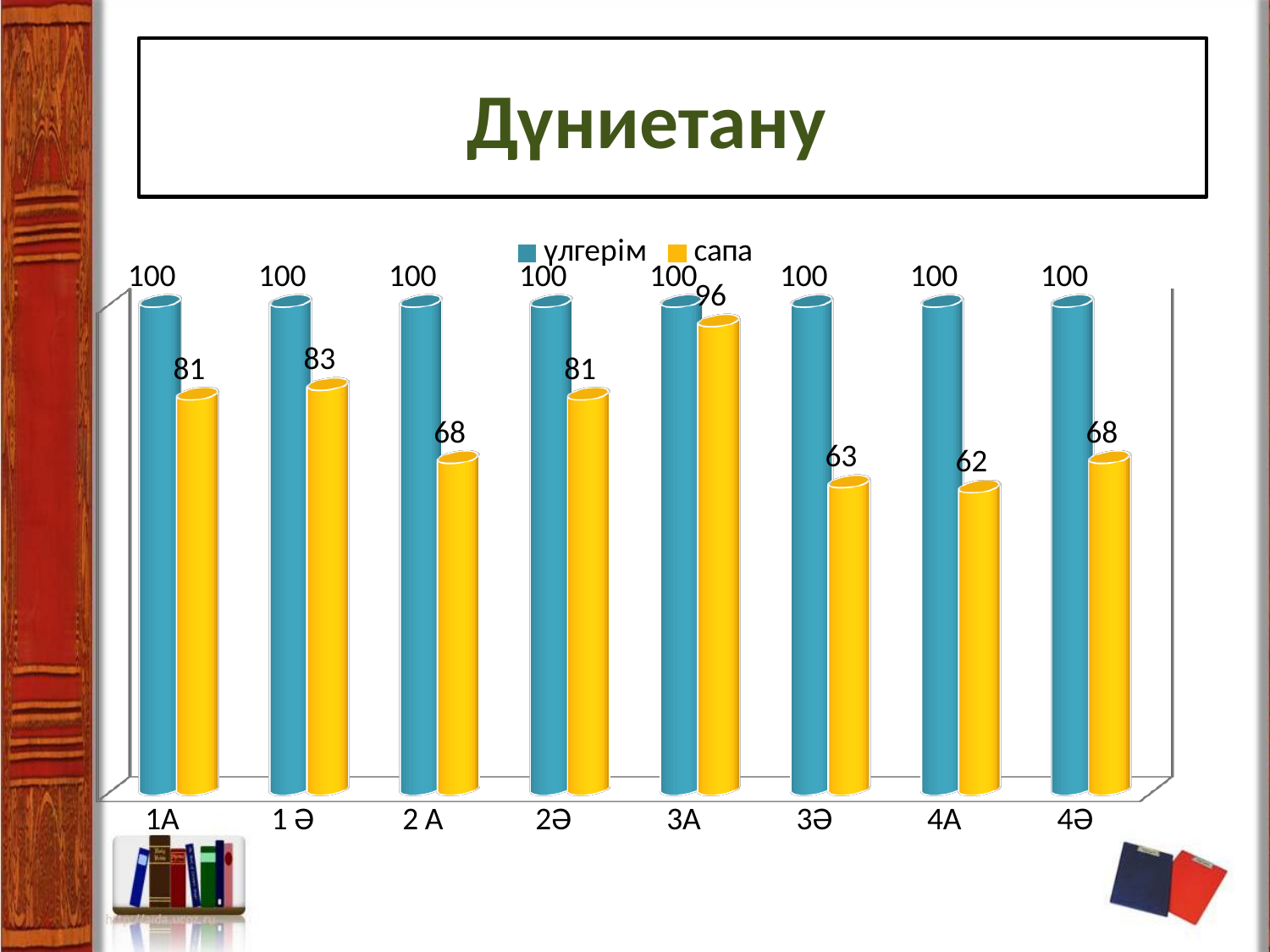
Which category has the lowest сапа value? 4А What is the difference between the үлгерім and сапа values for 1Ә? 17 What is the title of the slide? Дүниетану How many series does the legend list? 2 What is the сапа value for 3А? 96 How many categories are shown on the x axis? 8 What is the difference between the сапа values for 3А and 4А? 34 Which is larger, the сапа value for 1Ә or the сапа value for 3Ә? 1Ә What is the сапа value for 4А? 62 Which category has the highest сапа value? 3А What kind of chart is shown on the slide? bar chart What is the үлгерім value for 2Ә? 100